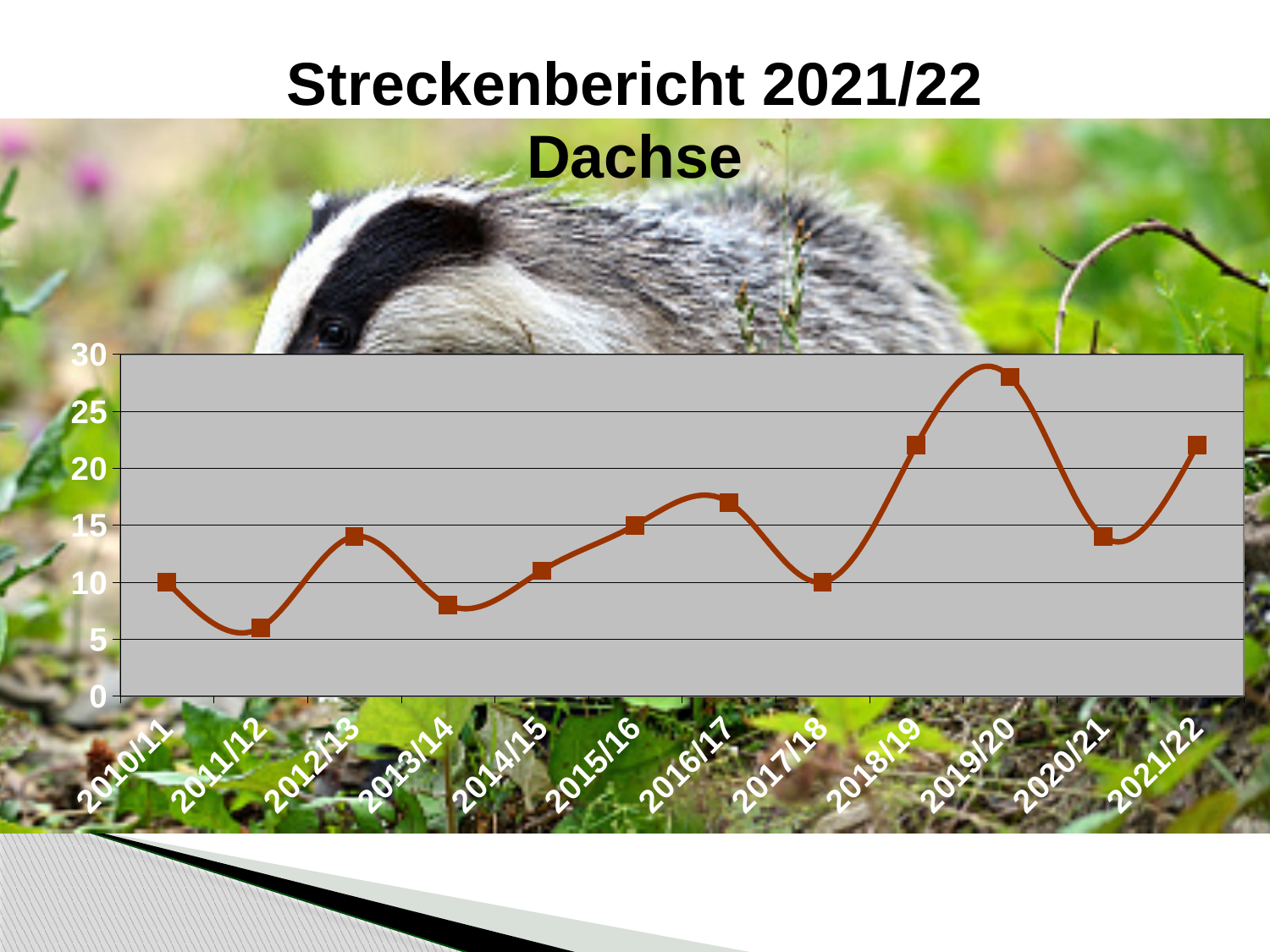
How many hunting seasons are plotted on the x axis? 12 Which season has the larger value, 2021/22 or 2010/11? 2021/22 Is the value for 2011/12 greater or less than 10? less Is the value for 2020/21 greater or less than 20? less Which season has the highest value? 2019/20 Which season has the larger value, 2019/20 or 2021/22? 2019/20 Is the value for 2018/19 greater or less than 20? greater What kind of chart is shown on the slide? line chart What is the title of the chart? Dachse Which season has the lowest value? 2011/12